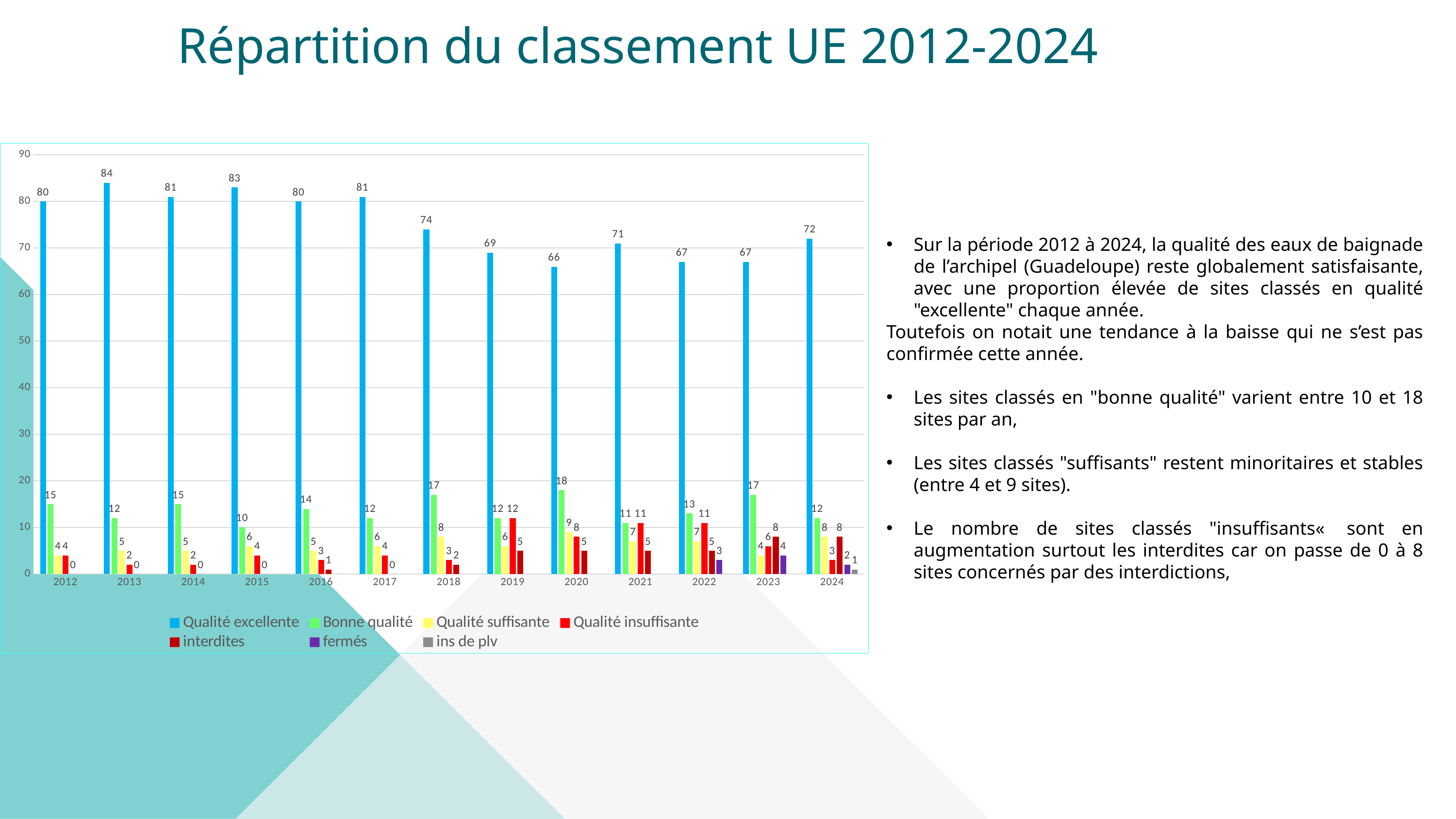
Which year has the lowest value for Qualité excellente? 2020 Which is larger in 2019: Bonne qualité or Qualité insuffisante? They are equal (12) What is the difference between Qualité excellente in 2013 and in 2020? 18 How many years are shown on the x axis? 13 What is the value of Bonne qualité in 2020? 18 How many series does the legend list? 7 What is the value of interdites in 2024? 8 Is the value for Qualité excellente in 2018 greater or less than 70? greater What is the title of the slide containing the chart? Répartition du classement UE 2012-2024 What is the value of Qualité excellente in 2013? 84 Which year has the highest value for Qualité excellente? 2013 What kind of chart is shown on the slide? bar chart